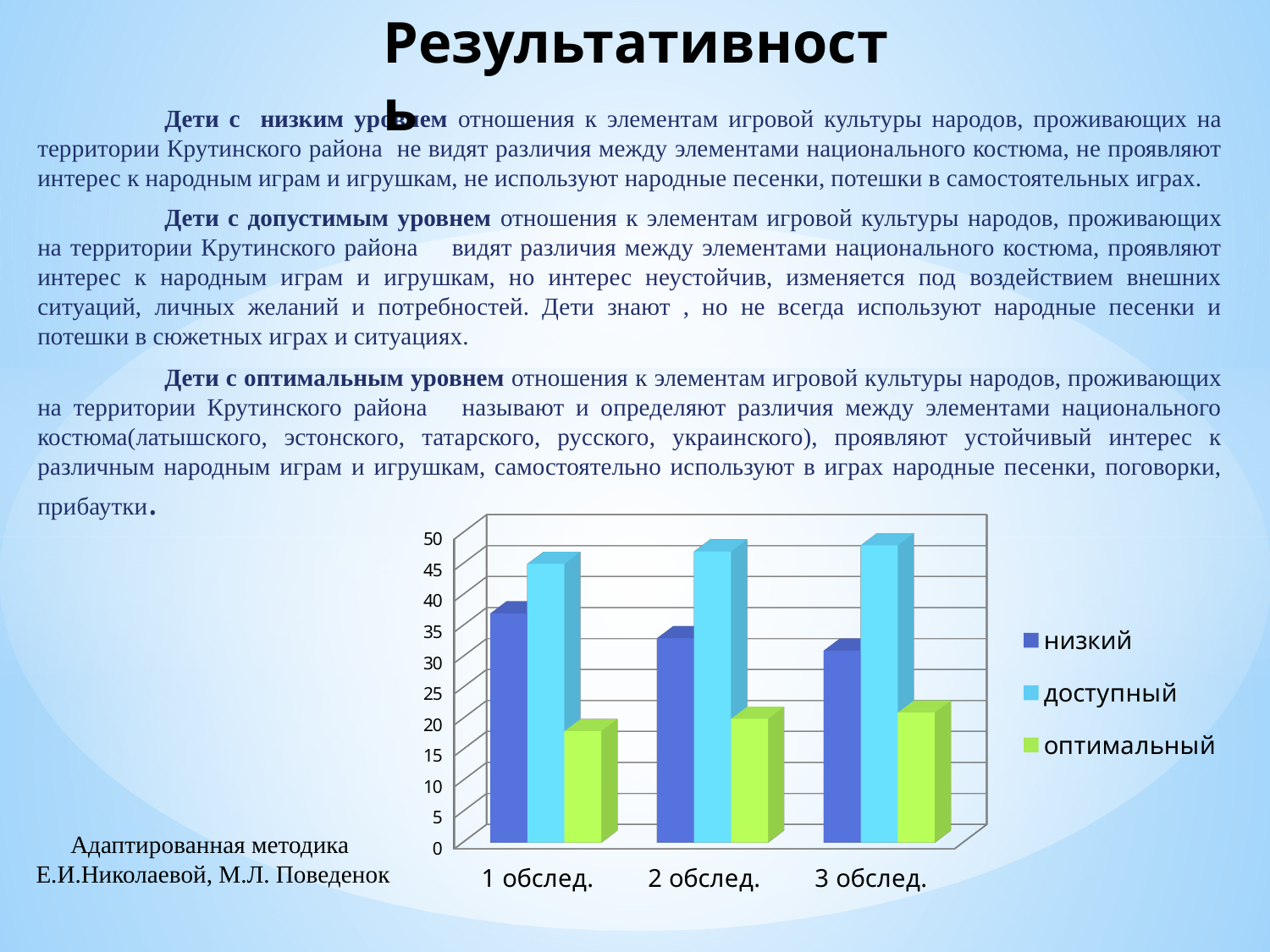
At 1 обслед., which is larger: the value for низкий or the value for доступный? доступный Do the values for the series доступный rise or fall from 1 обслед. to 3 обслед.? rise Is the value for низкий at 3 обслед. greater or less than 35? less How many categories are shown on the x axis of the chart? 3 In which category is the value for низкий the highest? 1 обслед. Is the value for низкий at 1 обслед. greater or less than 30? greater Is the value for оптимальный at 1 обслед. greater or less than 25? less How many series does the chart legend list? 3 What kind of chart is shown on the slide? bar chart Which colour represents the series оптимальный in the chart legend? green Do the values for the series низкий rise or fall from 1 обслед. to 3 обслед.? fall